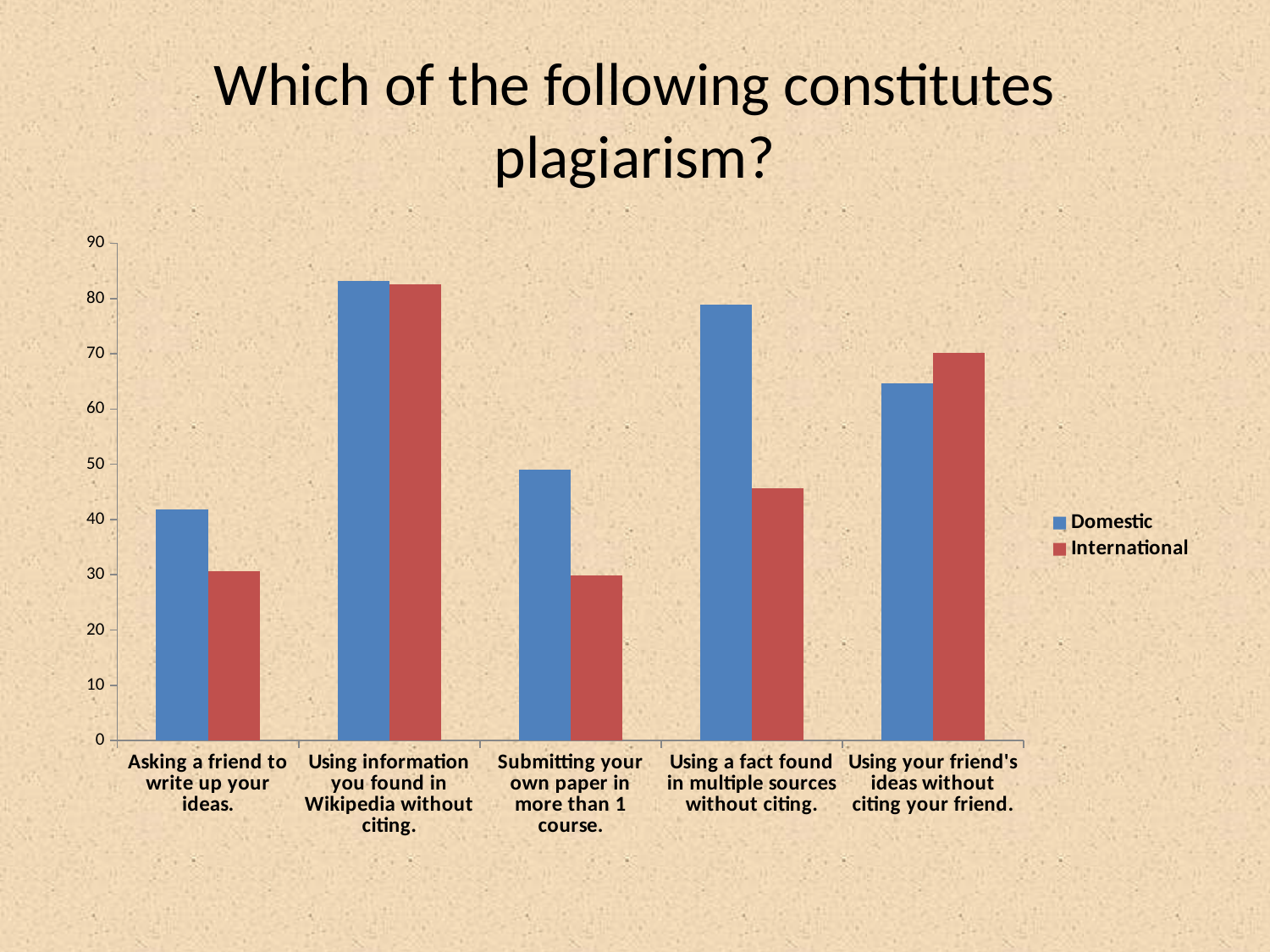
What is the title of the chart? Which of the following constitutes plagiarism? How many series does the legend list? 2 Is the International value for 'Asking a friend to write up your ideas.' greater or less than 40? less Which category has the highest Domestic value? Using information you found in Wikipedia without citing. Which category has the highest International value? Using information you found in Wikipedia without citing. Is the International value for 'Using a fact found in multiple sources without citing.' greater or less than 50? less How many categories are shown on the x axis? 5 Which category has the lowest Domestic value? Asking a friend to write up your ideas. For 'Using your friend's ideas without citing your friend.', which series has the larger value, Domestic or International? International Is the Domestic value for 'Using information you found in Wikipedia without citing.' greater or less than 80? greater What kind of chart is shown on the slide? bar chart